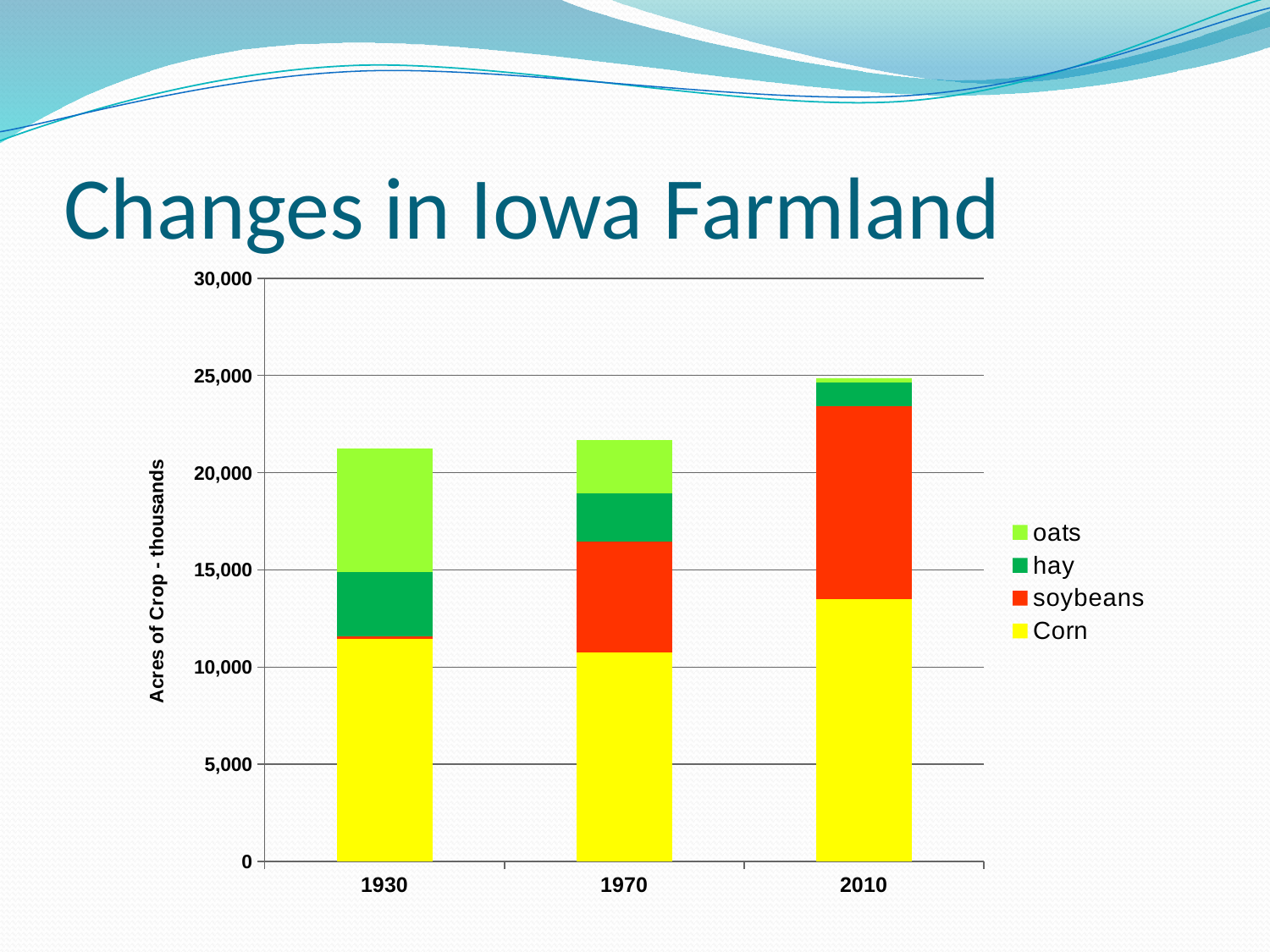
Is the total stacked value for 1930 greater or less than 25,000? less Is the Corn value for 1930 greater or less than 15,000? less How many series does the legend list? 4 What kind of chart is shown on the slide? stacked bar chart How many years (categories) are shown on the x axis? 3 Which year has the tallest stacked bar (largest total acres)? 2010 What is the title of the y axis? Acres of Crop - thousands Is the total stacked value for 2010 greater or less than 20,000? greater Which is larger, the soybeans segment in 2010 or the soybeans segment in 1930? 2010 Does the soybeans segment rise or fall from 1930 to 2010? rise Which is larger, the oats segment in 1930 or the oats segment in 2010? 1930